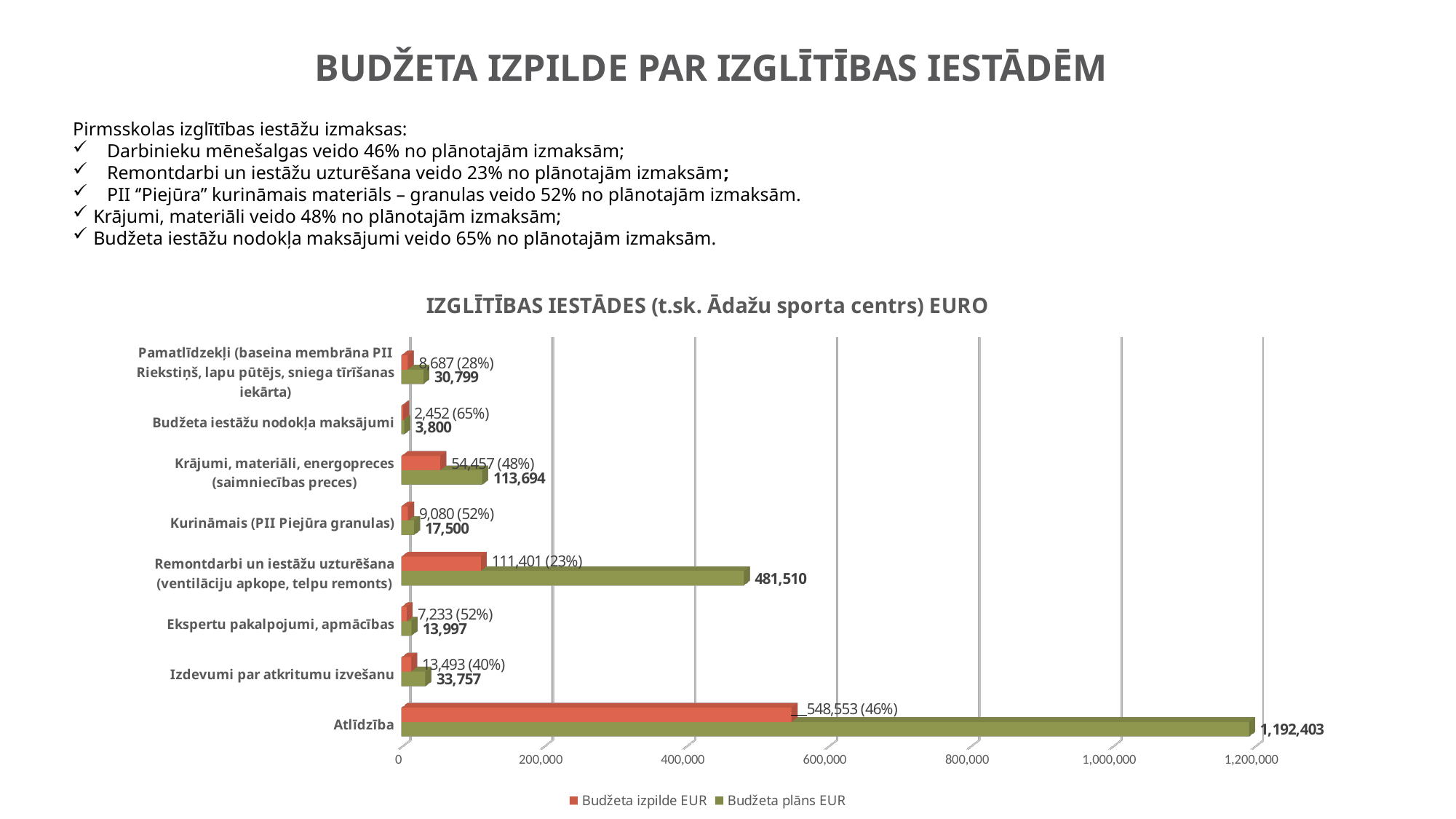
What kind of chart is shown on the slide? Bar chart What is the Budžeta plāns EUR value for Atlīdzība? 1,192,403 What is the title of the chart? IZGLĪTĪBAS IESTĀDES (t.sk. Ādažu sporta centrs) EURO Which category has the lowest Budžeta plāns EUR value? Budžeta iestāžu nodokļa maksājumi How many series does the legend list? 2 Which is larger: the Budžeta izpilde EUR for Izdevumi par atkritumu izvešanu or for Ekspertu pakalpojumi, apmācības? Izdevumi par atkritumu izvešanu What is the Budžeta plāns EUR value for Krājumi, materiāli, energopreces (saimniecības preces)? 113,694 What is the difference between the Budžeta plāns EUR and Budžeta izpilde EUR values for Atlīdzība? 643,850 Which category has the highest Budžeta plāns EUR value? Atlīdzība How many categories are shown on the chart? 8 What is the Budžeta izpilde EUR value for Remontdarbi un iestāžu uzturēšana (ventilāciju apkope, telpu remonts)? 111,401 What percentage of the plan does the Budžeta izpilde EUR for Kurināmais (PII Piejūra granulas) represent, as labelled on the chart? 52%